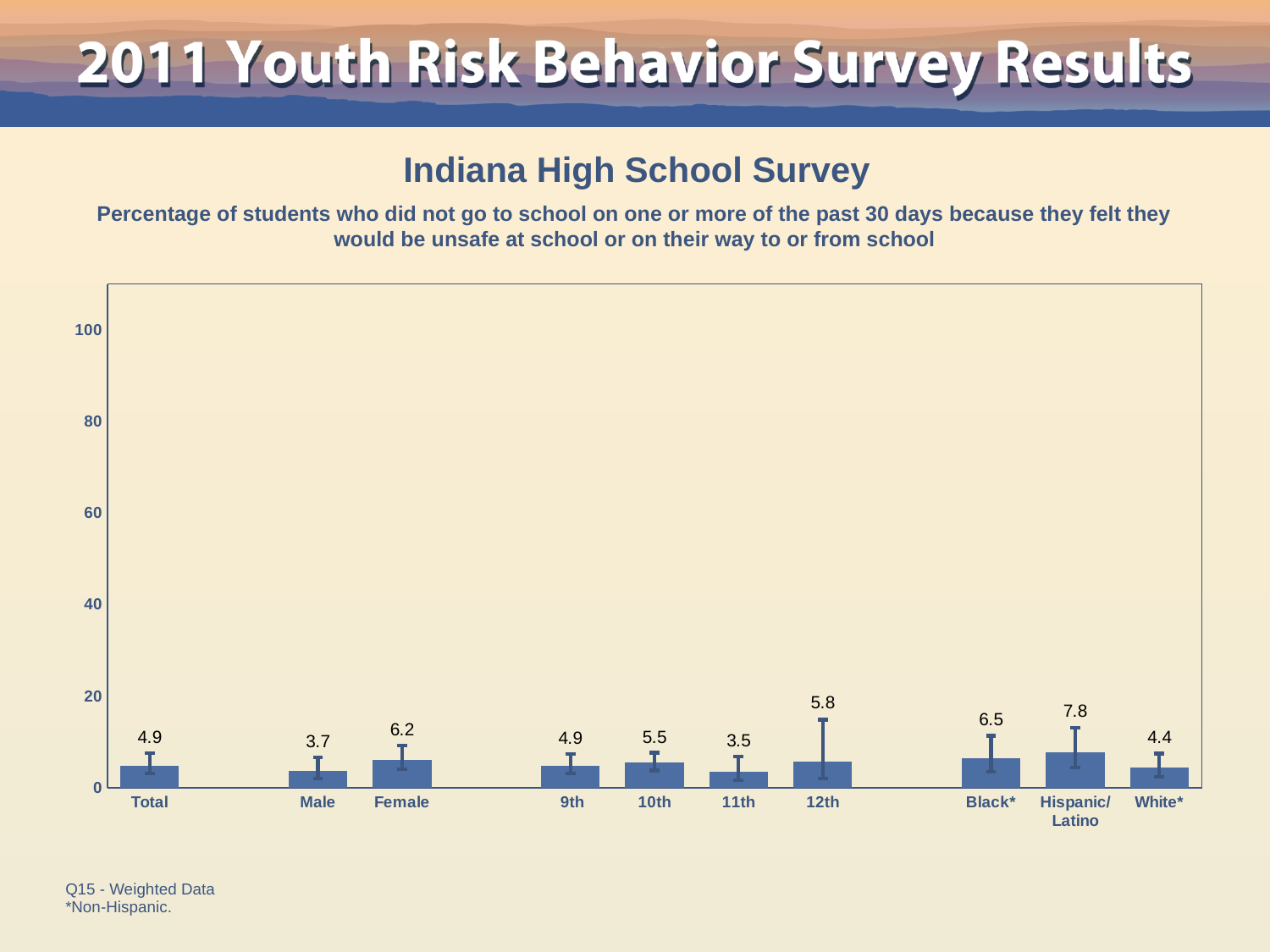
What kind of chart is this? bar chart What is the title of the chart? Indiana High School Survey What is the value for Hispanic/Latino? 7.8 Is the value for 10th greater or less than 20? less What is the value for 12th? 5.8 What is the difference between the Female and Male values? 2.5 Which category has the lowest value? 11th What is the value for Female? 6.2 What is the value for Total? 4.9 How many categories are shown on the x axis? 10 Which category has the highest value? Hispanic/Latino Which is larger, the value for Black* or the value for White*? Black*